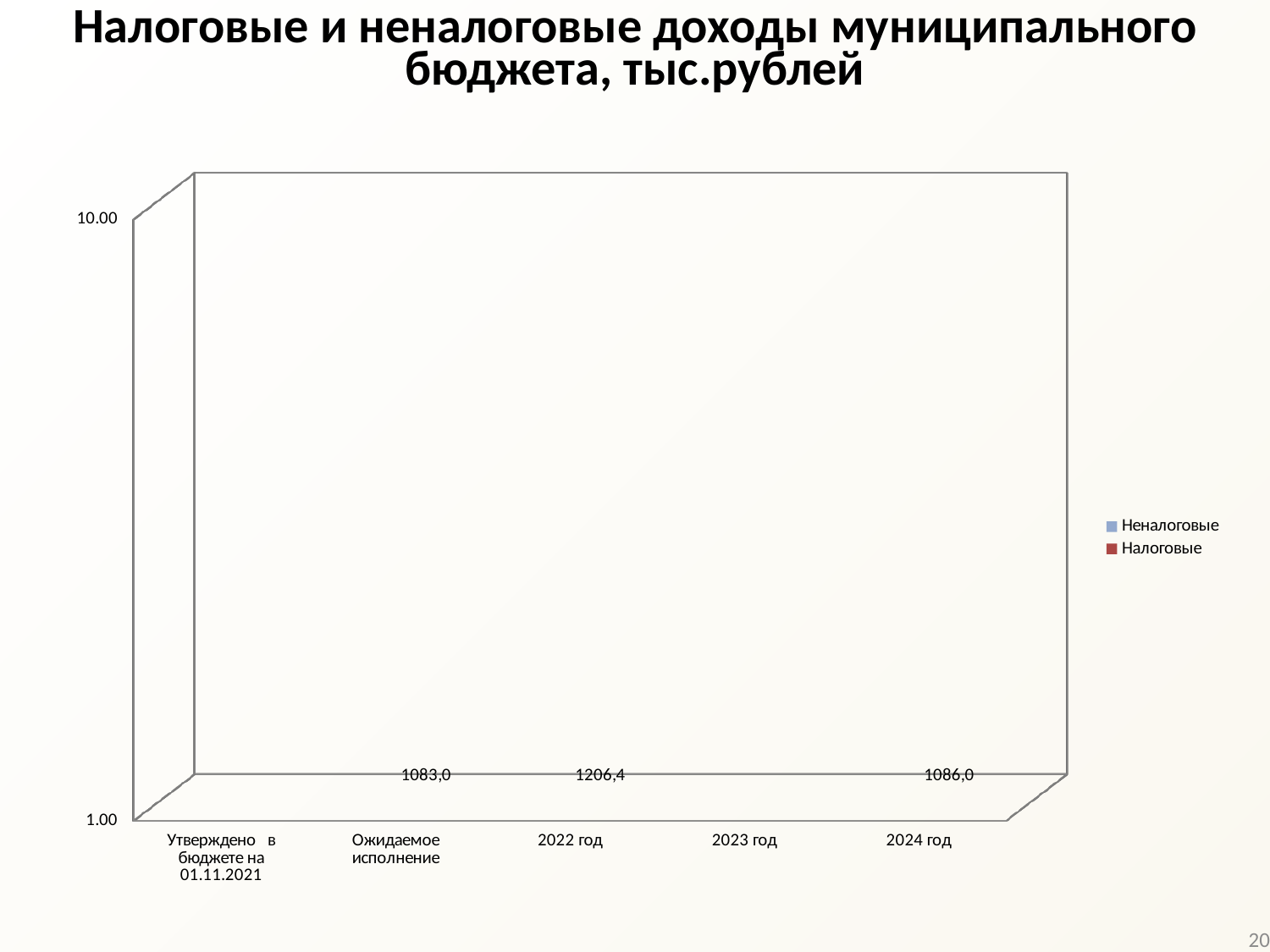
Among the data labels printed on the chart, which category has the highest value? 2022 год Among the data labels printed on the chart, which category has the lowest value? Ожидаемое исполнение How many categories are shown along the x axis? 5 What kind of chart is shown on the slide? bar chart What data label is printed for the category "Ожидаемое исполнение"? 1083,0 Which printed value is larger, the one for "2022 год" or the one for "2024 год"? 2022 год What data label is printed for the category "2024 год"? 1086,0 How many series does the legend list? 2 What data label is printed for the category "2022 год"? 1206,4 What are the two entries in the chart legend? Неналоговые, Налоговые What is the title of the chart on the slide? Налоговые и неналоговые доходы муниципального бюджета, тыс.рублей What is the difference between the printed values for "2022 год" and "Ожидаемое исполнение"? 123,4